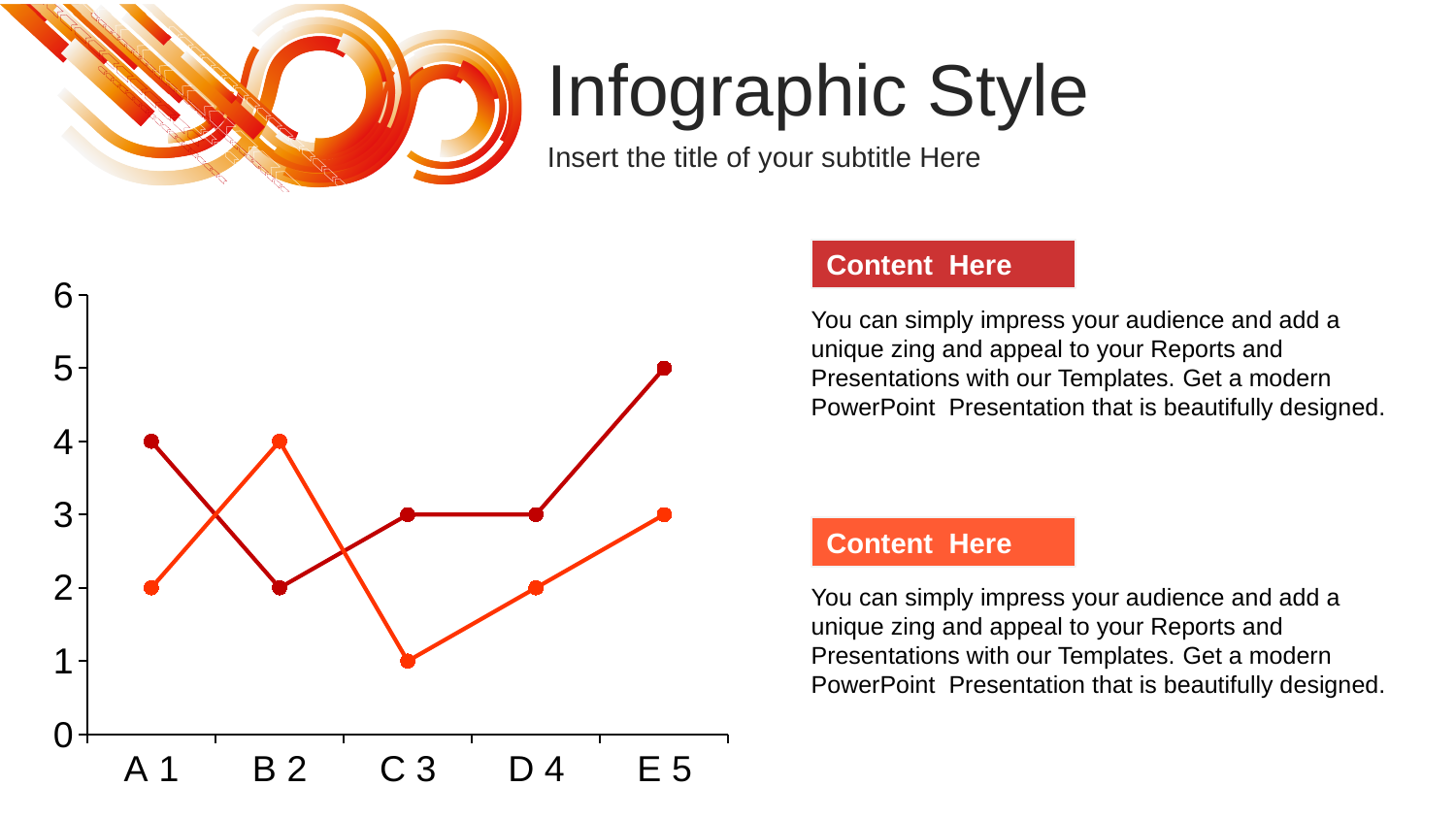
How many categories are shown on the x axis of the chart? 5 What is the value of the orange line at B 2? 4 What is the value of the dark red line at E 5? 5 What kind of chart is shown on the slide? line chart At B 2, which line has the larger value, the dark red line or the orange line? the orange line What is the value of the dark red line at A 1? 4 What is the value of the orange line at C 3? 1 What is the difference between the dark red line and the orange line at E 5? 2 At which category does the orange line reach its lowest value? C 3 At which category does the dark red line reach its highest value? E 5 Does the orange line rise or fall from C 3 to E 5? rise How many lines are plotted on the chart? 2